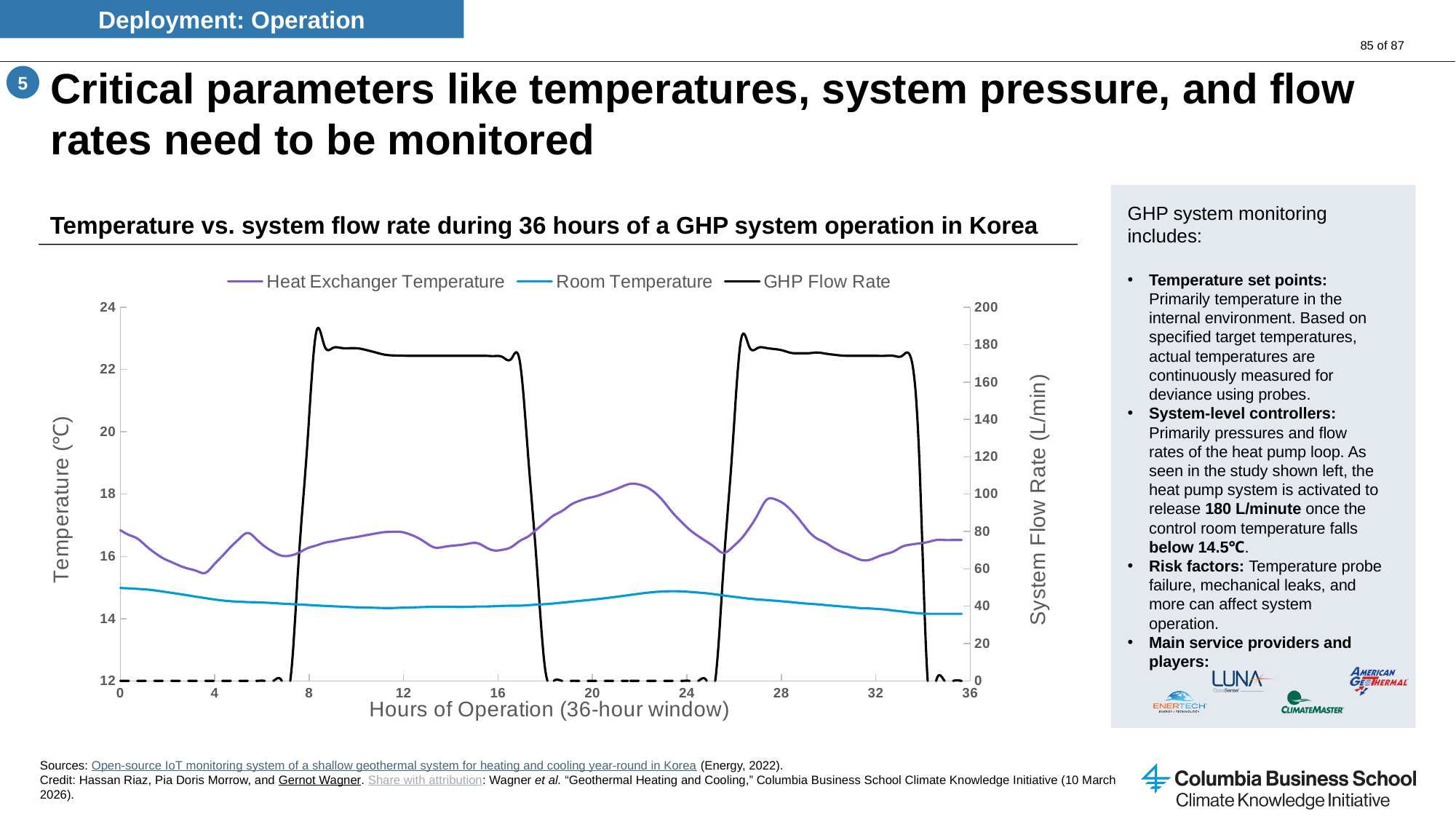
Is the Room Temperature at hour 36 greater or less than 16 °C? less What is the title of the chart? Temperature vs. system flow rate during 36 hours of a GHP system operation in Korea What is the label of the right-hand vertical axis of the chart? System Flow Rate (L/min) Is the Heat Exchanger Temperature at hour 22 greater or less than 16 °C? greater How many series does the chart legend list? 3 Is the Room Temperature at hour 0 greater or less than 16 °C? less What kind of chart is shown on the slide? Line chart Does the Room Temperature overall rise or fall from hour 0 to hour 36? fall At hour 12, which is higher: the Heat Exchanger Temperature or the Room Temperature? Heat Exchanger Temperature Which of the two temperature series reaches the highest temperature during the 36-hour window? Heat Exchanger Temperature